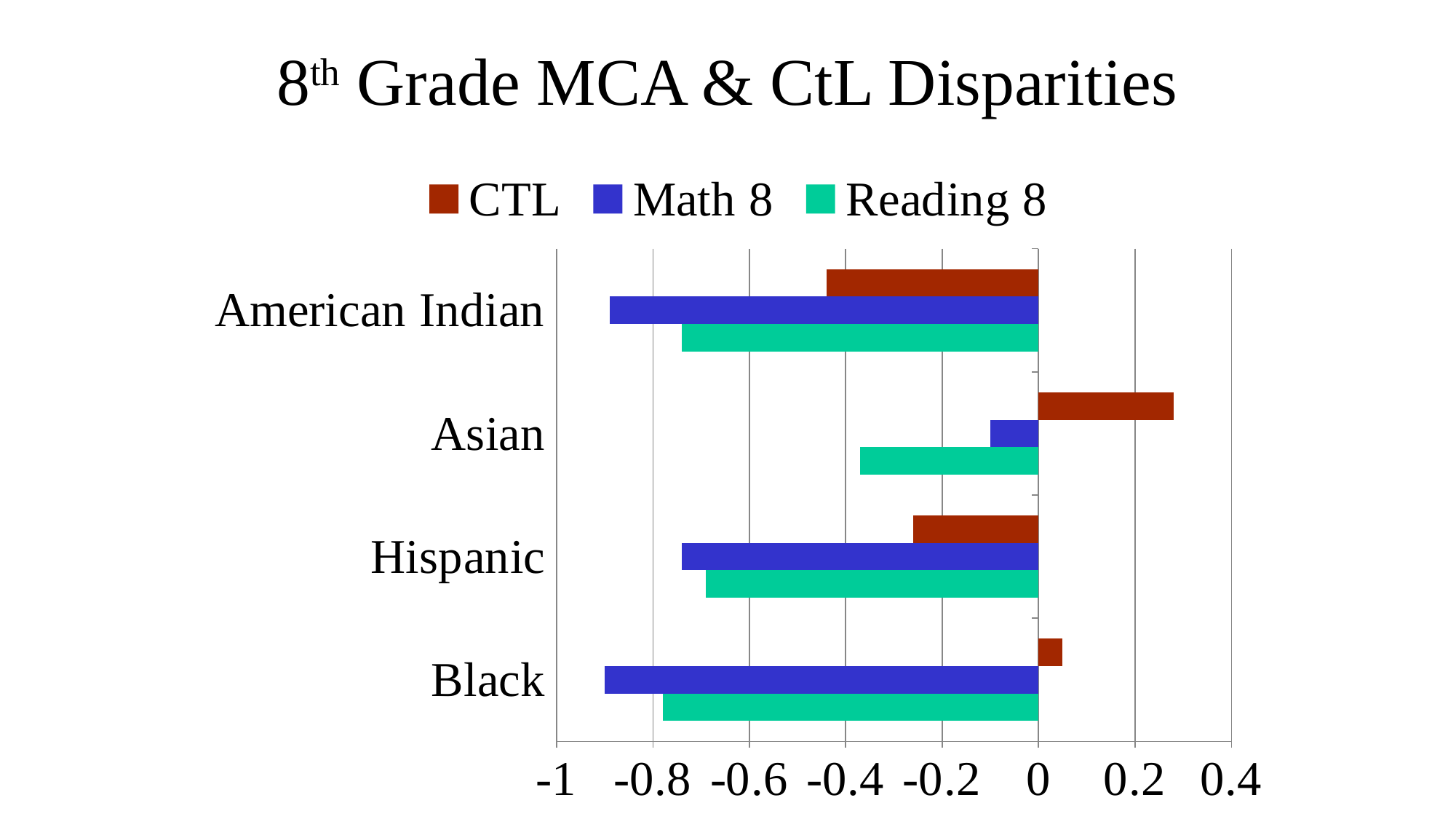
Which is larger, the CTL value for Asian or the CTL value for Black? Asian What is the title of the chart? 8th Grade MCA & CtL Disparities Which category has the highest CTL value? Asian Which category has the highest Reading 8 value? Asian What kind of chart is shown on the slide? bar chart Is the Math 8 value for American Indian greater or less than -0.8? less Is the Reading 8 value for Black greater or less than -0.6? less How many series does the legend list? 3 Which category has the highest Math 8 value? Asian How many categories (racial/ethnic groups) are shown on the chart? 4 Is the CTL value for Asian greater or less than 0.2? greater Which series is shown in blue in the legend? Math 8